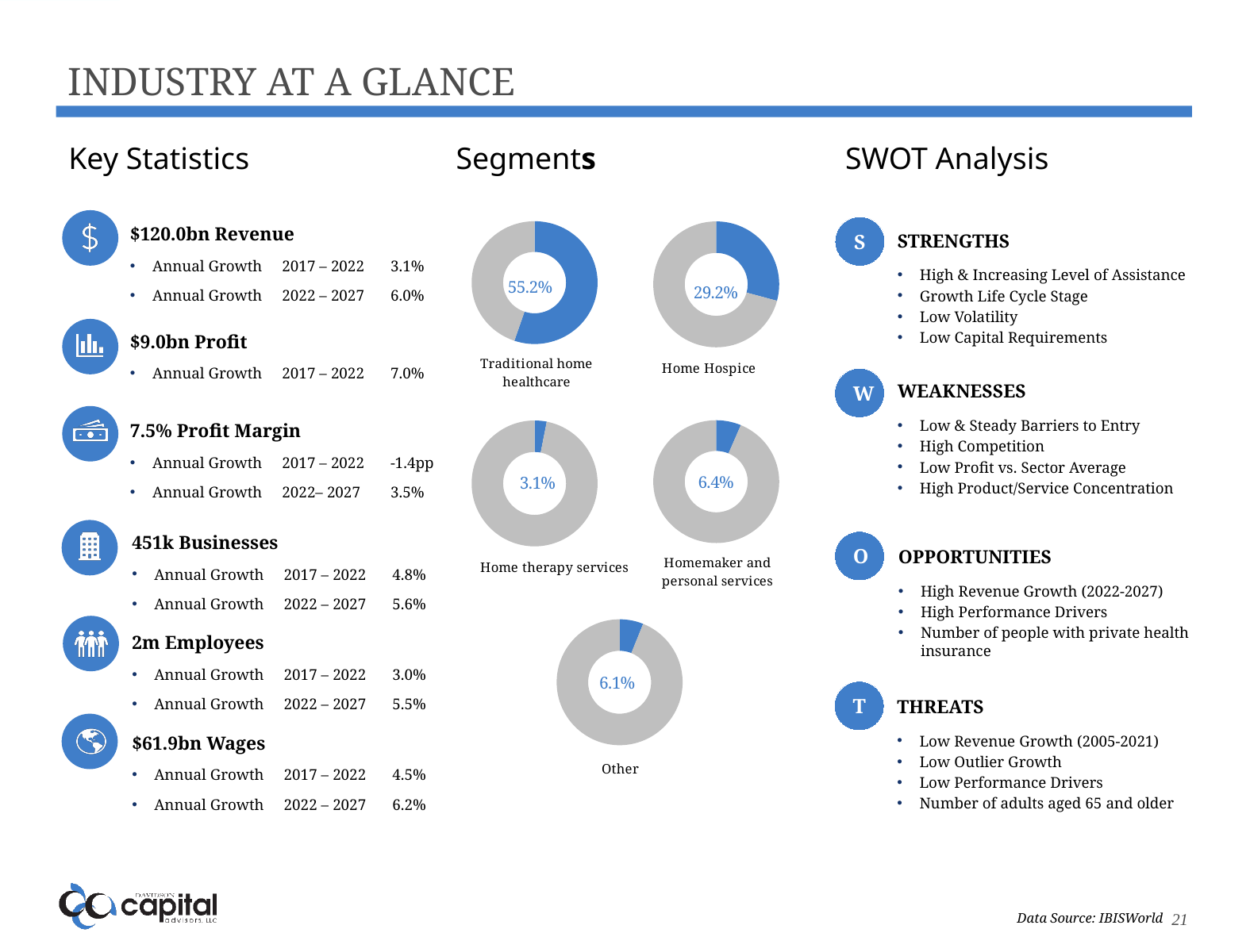
In the Segments section, what share is shown on the Home Hospice donut chart? 29.2% In the Segments section, what share is shown on the Traditional home healthcare donut chart? 55.2% How many donut charts are shown in the Segments section? 5 In the Segments section, what colour is used for the highlighted share in each donut chart? Blue In the Segments section, what share is shown on the Home therapy services donut chart? 3.1% Among the Segments donut charts, which segment has the largest share? Traditional home healthcare In the Segments section, what share is shown on the Other donut chart? 6.1% In the Segments section, which is larger: the Homemaker and personal services share or the Other share? Homemaker and personal services What type of chart is used for each segment in the Segments section? Donut chart Among the Segments donut charts, which segment has the smallest share? Home therapy services In the Segments section, what share is shown on the Homemaker and personal services donut chart? 6.4% In the Segments section, what is the difference between the Traditional home healthcare share and the Home Hospice share? 26.0%